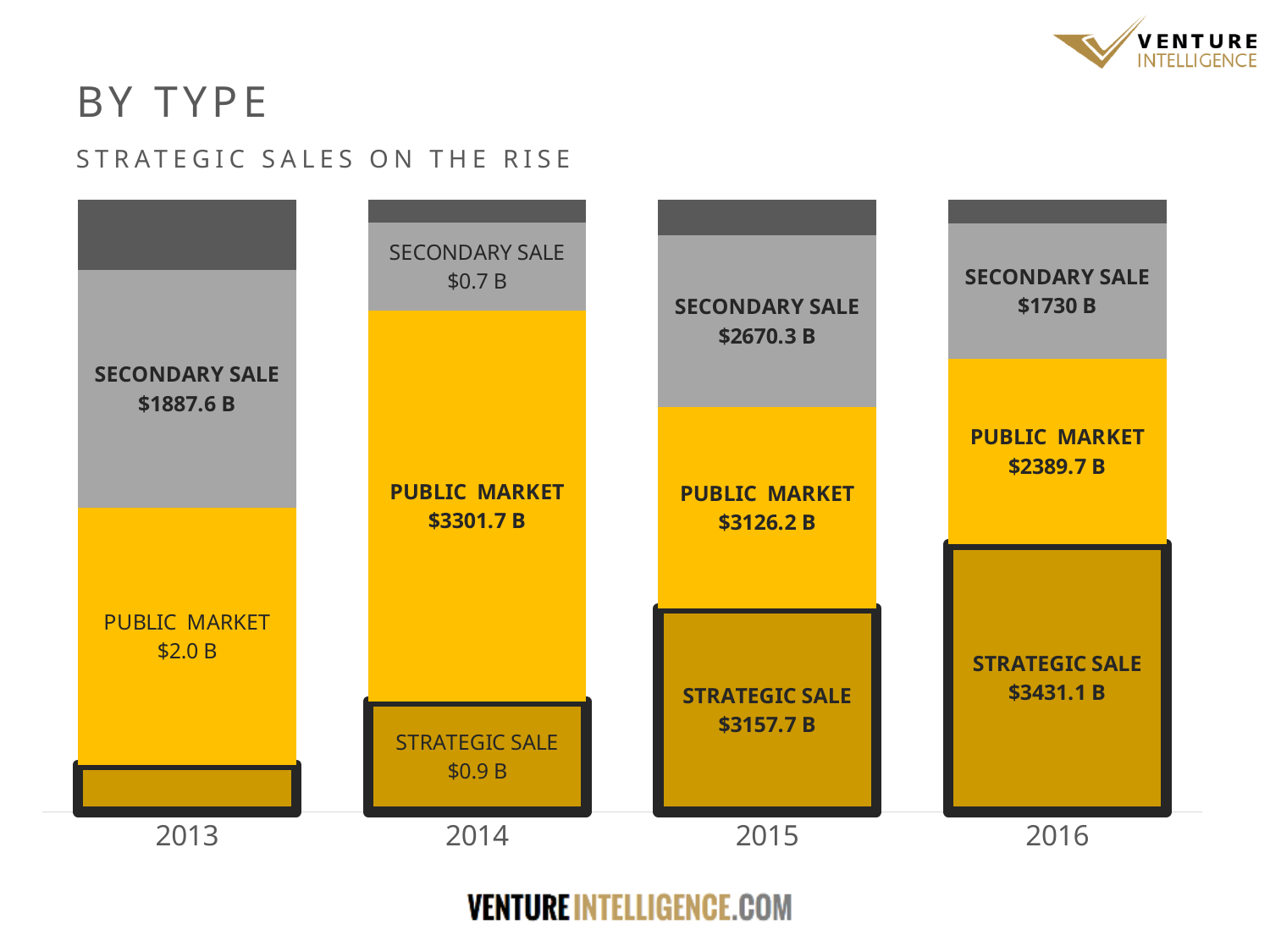
Which year has the highest labelled Strategic Sale value? 2016 Which is larger, the Public Market value in 2015 or in 2016? 2015 How many years are shown on the x axis of the chart? 4 What is the value of Secondary Sale in 2013? $1887.6 B What is the value of Public Market in 2014? $3301.7 B What is the value of Strategic Sale in 2014? $0.9 B What is the difference between the Strategic Sale values for 2016 and 2015? $273.4 B Which year has the lowest labelled Secondary Sale value? 2014 What kind of chart is shown on the slide? Stacked bar chart What is the value of Strategic Sale in 2016? $3431.1 B What is the value of Secondary Sale in 2015? $2670.3 B What is the subtitle of the chart on the slide? Strategic Sales on the Rise